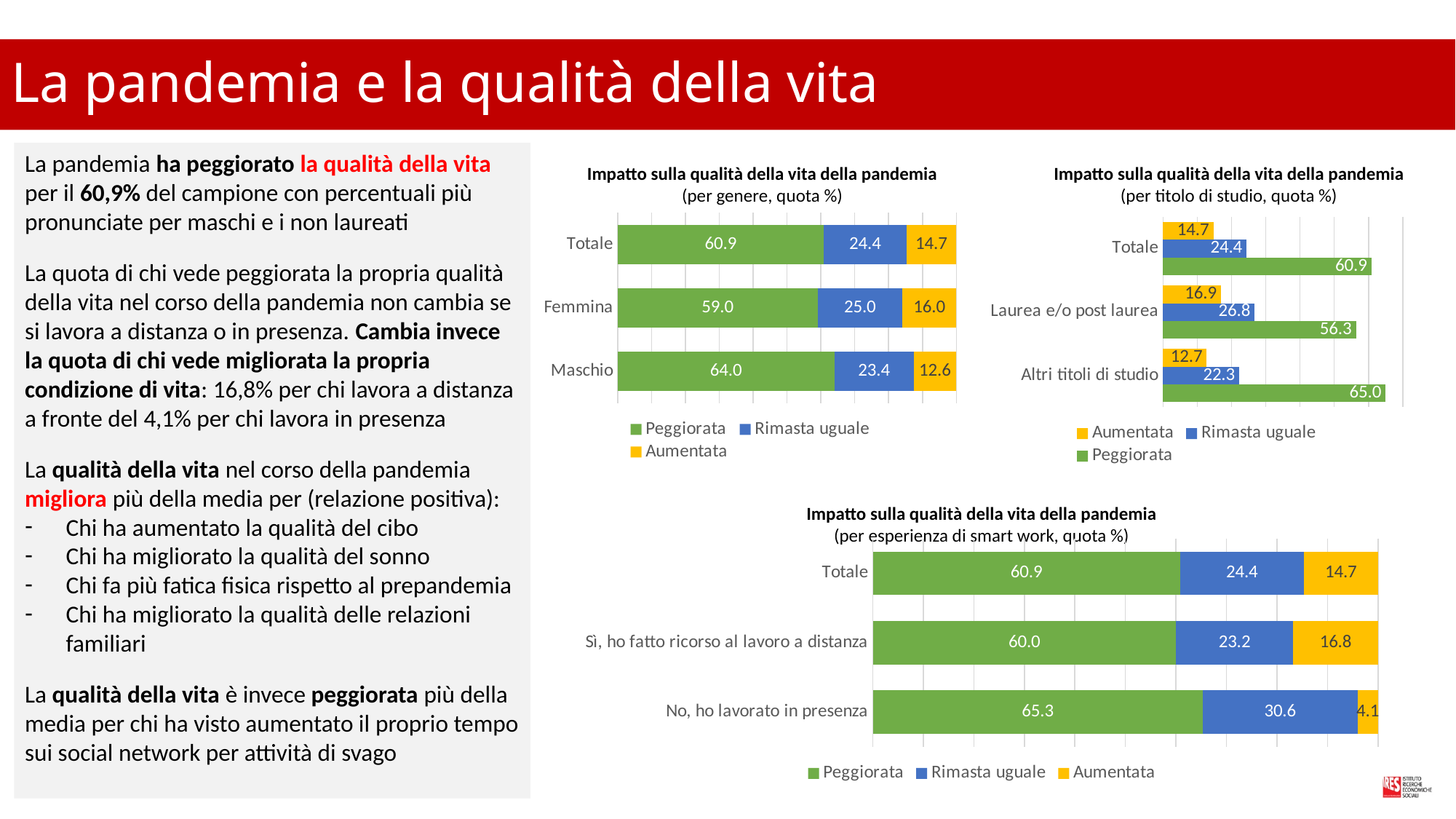
In the chart 'Impatto sulla qualità della vita della pandemia (per titolo di studio, quota %)', what is the 'Peggiorata' value for 'Altri titoli di studio'? 65.0 In the chart 'Impatto sulla qualità della vita della pandemia (per genere, quota %)', what is the 'Aumentata' value for Femmina? 16.0 In the chart 'Impatto sulla qualità della vita della pandemia (per titolo di studio, quota %)', how many categories are shown on the vertical axis? 3 In the chart 'Impatto sulla qualità della vita della pandemia (per esperienza di smart work, quota %)', what is the total of the stacked bar for 'Sì, ho fatto ricorso al lavoro a distanza'? 100.0 What type of chart is 'Impatto sulla qualità della vita della pandemia (per esperienza di smart work, quota %)'? Stacked bar chart In the chart 'Impatto sulla qualità della vita della pandemia (per genere, quota %)', what is the difference between the 'Peggiorata' values for Maschio and Femmina? 5.0 In the chart 'Impatto sulla qualità della vita della pandemia (per genere, quota %)', which category has the highest 'Peggiorata' value? Maschio In the chart 'Impatto sulla qualità della vita della pandemia (per genere, quota %)', what is the 'Peggiorata' value for Maschio? 64.0 In the chart 'Impatto sulla qualità della vita della pandemia (per titolo di studio, quota %)', what is the 'Rimasta uguale' value for 'Laurea e/o post laurea'? 26.8 In the chart 'Impatto sulla qualità della vita della pandemia (per esperienza di smart work, quota %)', is the 'Rimasta uguale' value larger for 'Sì, ho fatto ricorso al lavoro a distanza' or for 'No, ho lavorato in presenza'? No, ho lavorato in presenza In the chart 'Impatto sulla qualità della vita della pandemia (per esperienza di smart work, quota %)', what is the 'Aumentata' value for 'No, ho lavorato in presenza'? 4.1 In the chart 'Impatto sulla qualità della vita della pandemia (per titolo di studio, quota %)', which category has the lowest 'Aumentata' value? Altri titoli di studio